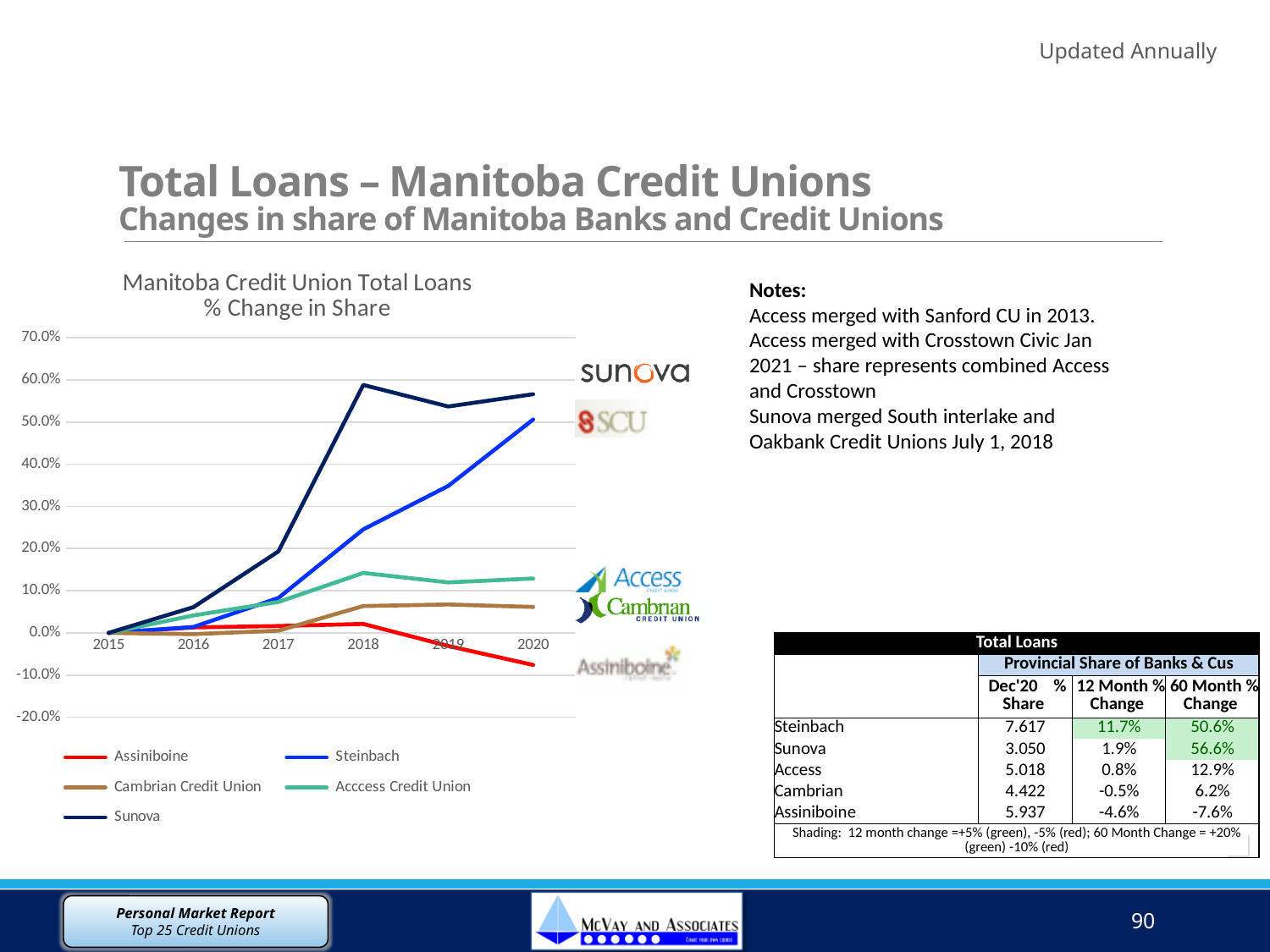
How many series does the chart legend list? 5 In 2019, which is larger: the value for Sunova or the value for Steinbach? Sunova Which credit union has the lowest % change in share in 2020? Assiniboine Is the value for Assiniboine in 2020 greater or less than 0.0%? less Which credit union has the highest % change in share in 2020? Sunova Is the value for Sunova in 2018 greater or less than 50.0%? greater What kind of chart is shown on the slide? line chart Is the value for Steinbach in 2020 greater or less than 40.0%? greater Does the Steinbach line rise or fall from 2015 to 2020? rise How many years are shown along the x axis of the chart? 6 What is the title of the chart? Manitoba Credit Union Total Loans % Change in Share